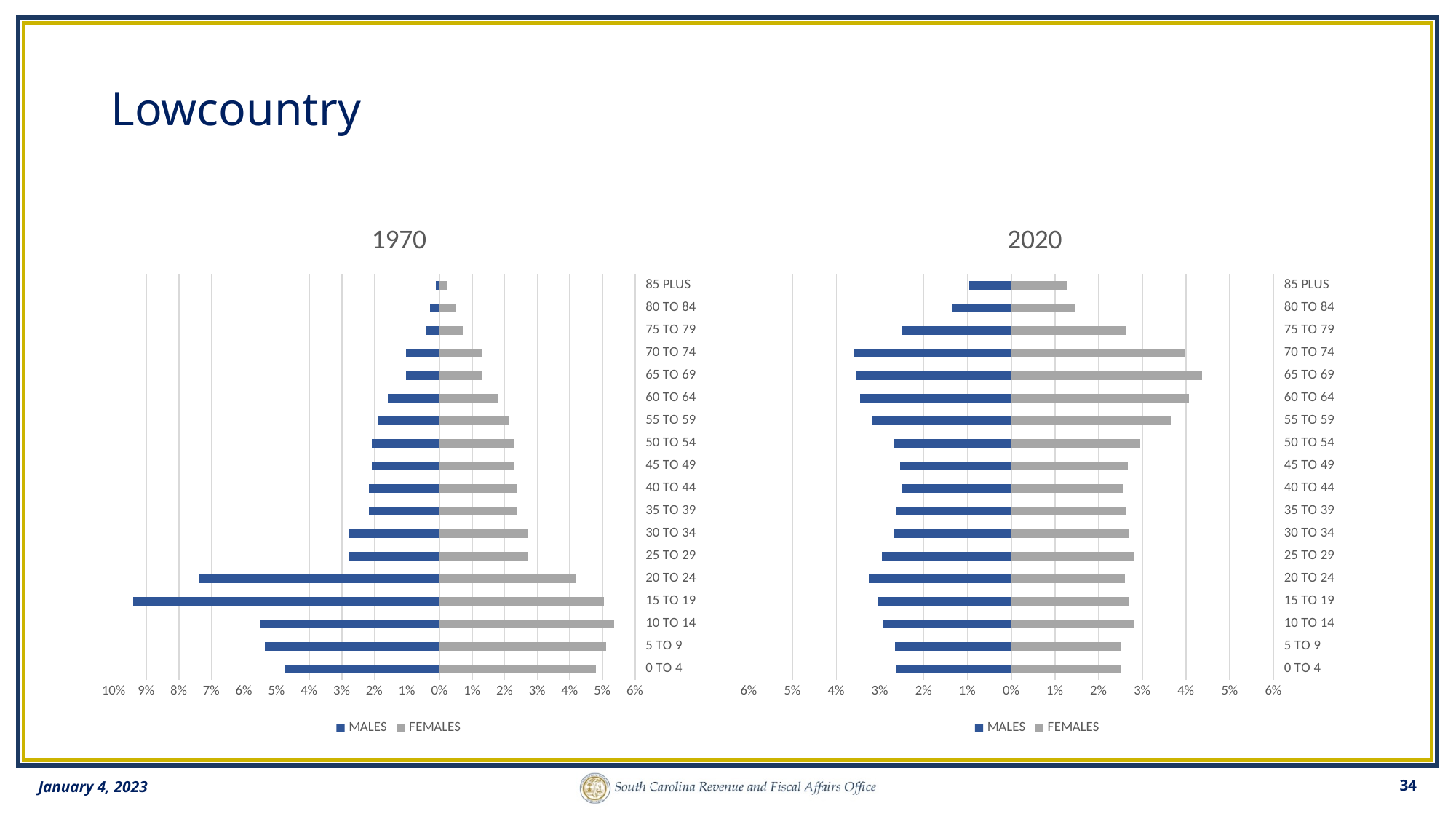
What kind of chart is the 1970 chart? bar chart How many series does the legend of the 1970 chart list? 2 In the 1970 chart, which is larger, the MALES value for 15 TO 19 or the MALES value for 20 TO 24? 15 TO 19 In the 1970 chart, which age group has the shortest MALES bar? 85 PLUS In the 1970 chart, which age group has the longest MALES bar? 15 TO 19 In the 2020 chart, which age group has the longest FEMALES bar? 65 TO 69 In the 2020 chart, which age group has the shortest MALES bar? 85 PLUS In the 1970 chart, is the MALES value for 15 TO 19 greater or less than 8%? greater In the 1970 chart, do the FEMALES bars get shorter or longer moving from 25 TO 29 up to 85 PLUS? shorter In the 1970 chart, is the FEMALES value for 85 PLUS greater or less than 1%? less In the 2020 chart, is the FEMALES value for 65 TO 69 greater or less than 4%? greater How many age groups are shown in the 2020 chart? 18